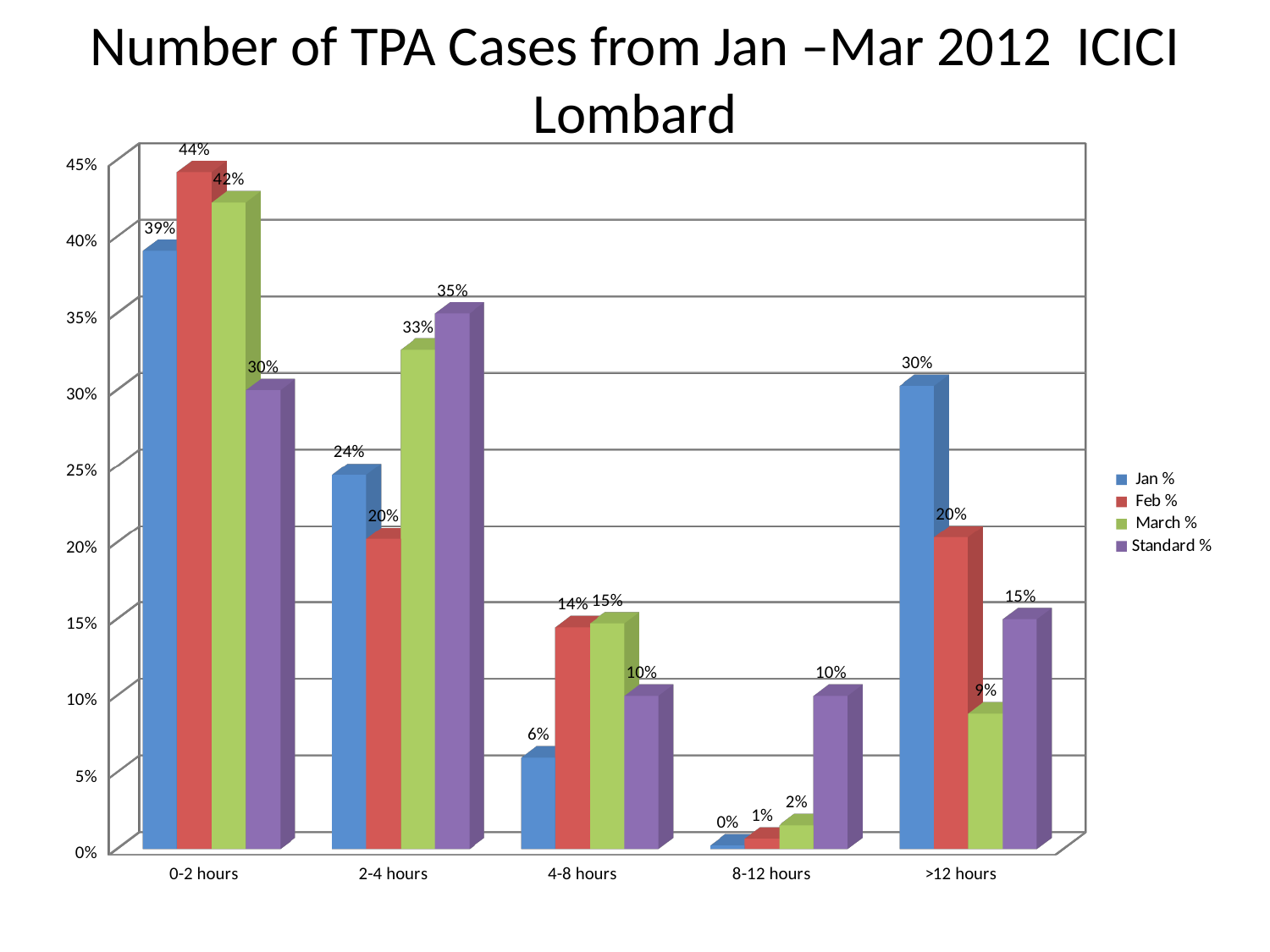
How many series does the legend list? 4 Is the Jan % value for the >12 hours category greater or less than 25%? greater How many categories are shown on the x axis? 5 What kind of chart is shown on the slide? Bar chart Which category has the highest Feb % value? 0-2 hours What is the Standard % value for the 2-4 hours category? 35% What is the difference between the Feb % and Jan % values for the 0-2 hours category? 5% What is the March % value for the >12 hours category? 9% What is the title of the chart? Number of TPA Cases from Jan –Mar 2012 ICICI Lombard Which is larger for the 4-8 hours category, the Feb % value or the Jan % value? Feb % Which category has the lowest Jan % value? 8-12 hours What is the Jan % value for the 0-2 hours category? 39%